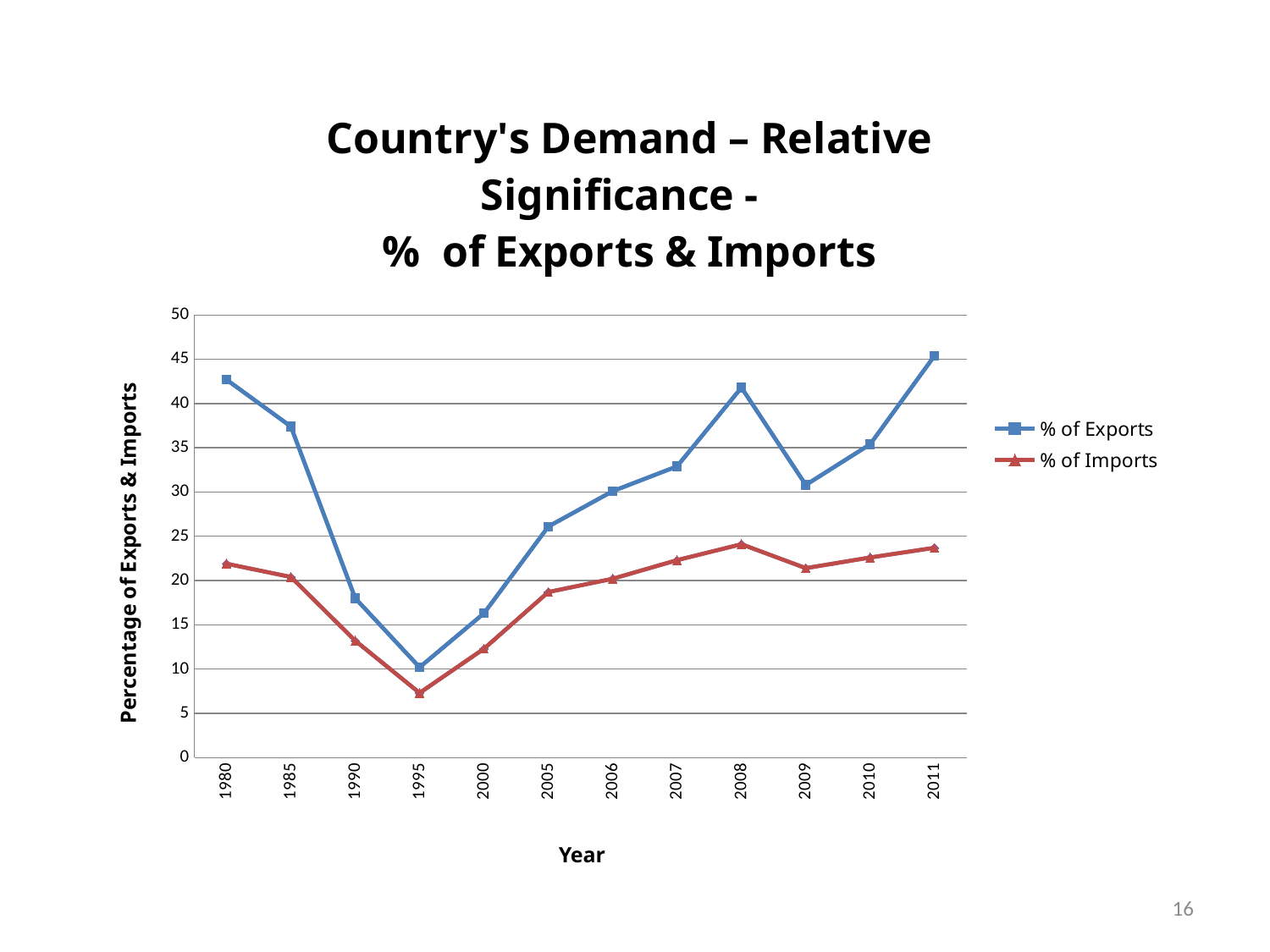
In which year is the % of Imports lowest? 1995 In which year is the % of Exports lowest? 1995 In which year is the % of Exports highest? 2011 Is the % of Imports in 2008 greater or less than 25? less What kind of chart is shown on the slide? line chart Is the % of Imports in 1995 greater or less than 10? less Is the % of Exports in 1980 greater or less than 40? greater How many series does the legend list? 2 How many years are plotted along the x axis? 12 Which is larger in 2011, the % of Exports or the % of Imports? % of Exports Does the % of Exports rise or fall from 1980 to 1995? fall